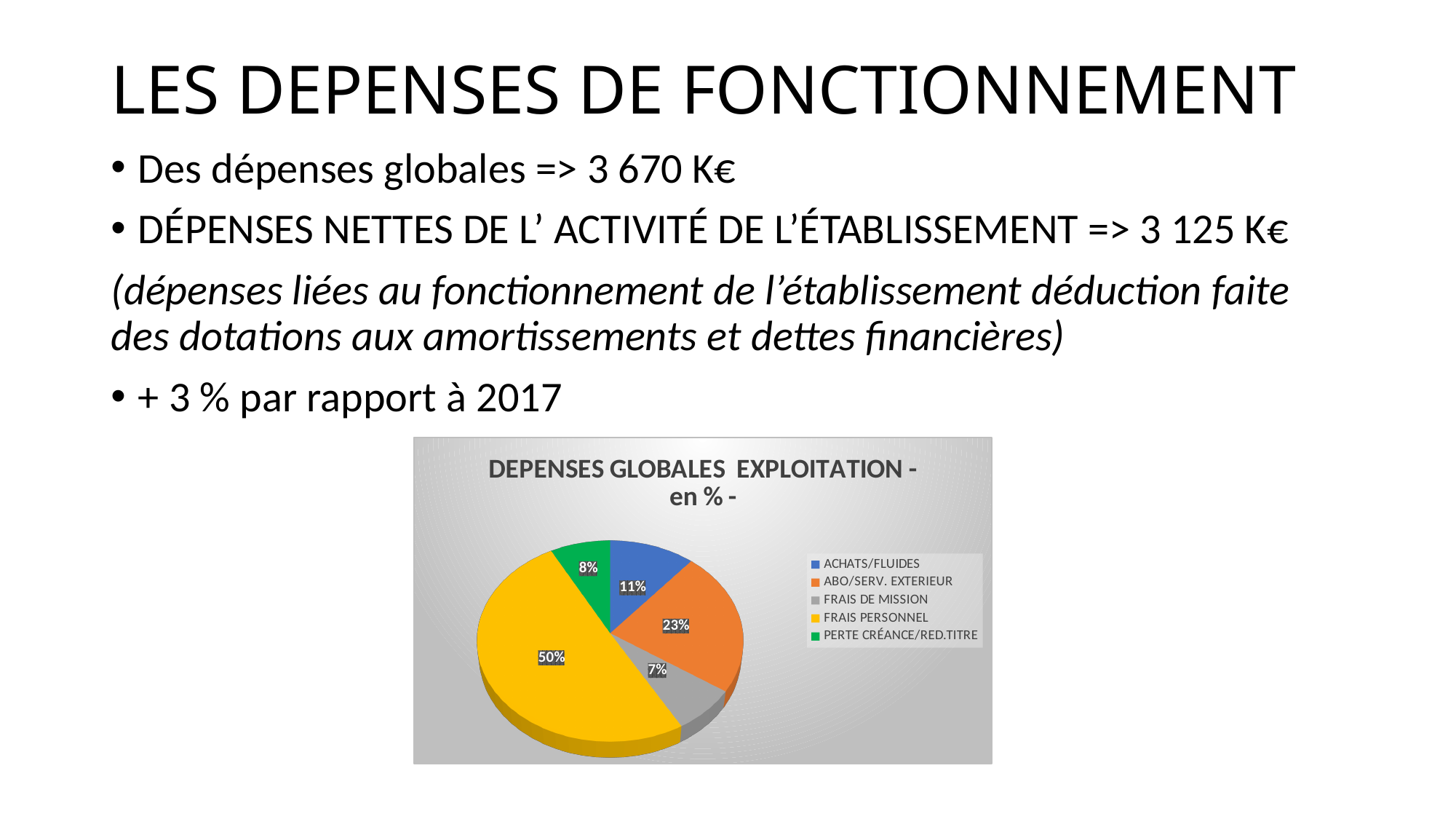
What kind of chart is shown on the slide? pie chart Which is larger, the share for ACHATS/FLUIDES or the share for PERTE CRÉANCE/RED.TITRE? ACHATS/FLUIDES What is the difference in percentage points between FRAIS PERSONNEL and ABO/SERV. EXTERIEUR? 27 What percentage does the FRAIS PERSONNEL slice represent? 50% What percentage does the PERTE CRÉANCE/RED.TITRE slice represent? 8% Which category has the smallest share of the pie? FRAIS DE MISSION What percentage does the ABO/SERV. EXTERIEUR slice represent? 23% What percentage does the FRAIS DE MISSION slice represent? 7% How many categories does the legend list? 5 Which category has the largest share of the pie? FRAIS PERSONNEL What percentage does the ACHATS/FLUIDES slice represent? 11% What is the title of the chart? DEPENSES GLOBALES EXPLOITATION - en % -